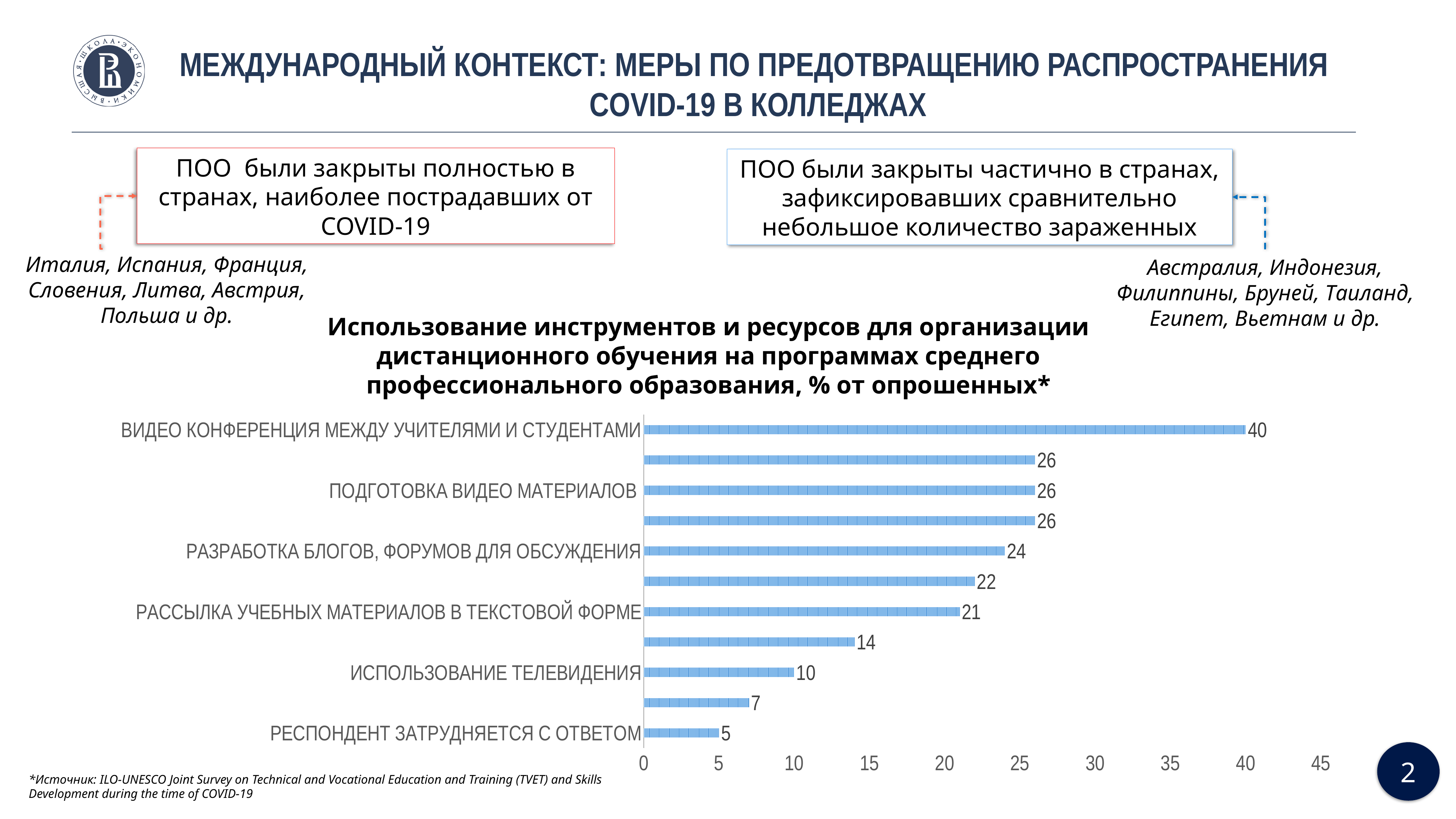
Which category has the lowest value in the chart? РЕСПОНДЕНТ ЗАТРУДНЯЕТСЯ С ОТВЕТОМ What value is shown for РАЗРАБОТКА БЛОГОВ, ФОРУМОВ ДЛЯ ОБСУЖДЕНИЯ? 24 What is the difference between the values for РАССЫЛКА УЧЕБНЫХ МАТЕРИАЛОВ В ТЕКСТОВОЙ ФОРМЕ and РЕСПОНДЕНТ ЗАТРУДНЯЕТСЯ С ОТВЕТОМ? 16 What kind of chart is shown on the slide? bar chart How many bars are plotted in the chart? 11 What value is shown for ВИДЕО КОНФЕРЕНЦИЯ МЕЖДУ УЧИТЕЛЯМИ И СТУДЕНТАМИ? 40 Which is larger: the value for РАЗРАБОТКА БЛОГОВ, ФОРУМОВ ДЛЯ ОБСУЖДЕНИЯ or the value for ИСПОЛЬЗОВАНИЕ ТЕЛЕВИДЕНИЯ? РАЗРАБОТКА БЛОГОВ, ФОРУМОВ ДЛЯ ОБСУЖДЕНИЯ Which category has the highest value in the chart? ВИДЕО КОНФЕРЕНЦИЯ МЕЖДУ УЧИТЕЛЯМИ И СТУДЕНТАМИ What is the difference between the values for ВИДЕО КОНФЕРЕНЦИЯ МЕЖДУ УЧИТЕЛЯМИ И СТУДЕНТАМИ and ПОДГОТОВКА ВИДЕО МАТЕРИАЛОВ? 14 What value is shown for ПОДГОТОВКА ВИДЕО МАТЕРИАЛОВ? 26 What value is shown for ИСПОЛЬЗОВАНИЕ ТЕЛЕВИДЕНИЯ? 10 Is the value for РАССЫЛКА УЧЕБНЫХ МАТЕРИАЛОВ В ТЕКСТОВОЙ ФОРМЕ greater or less than 25? less